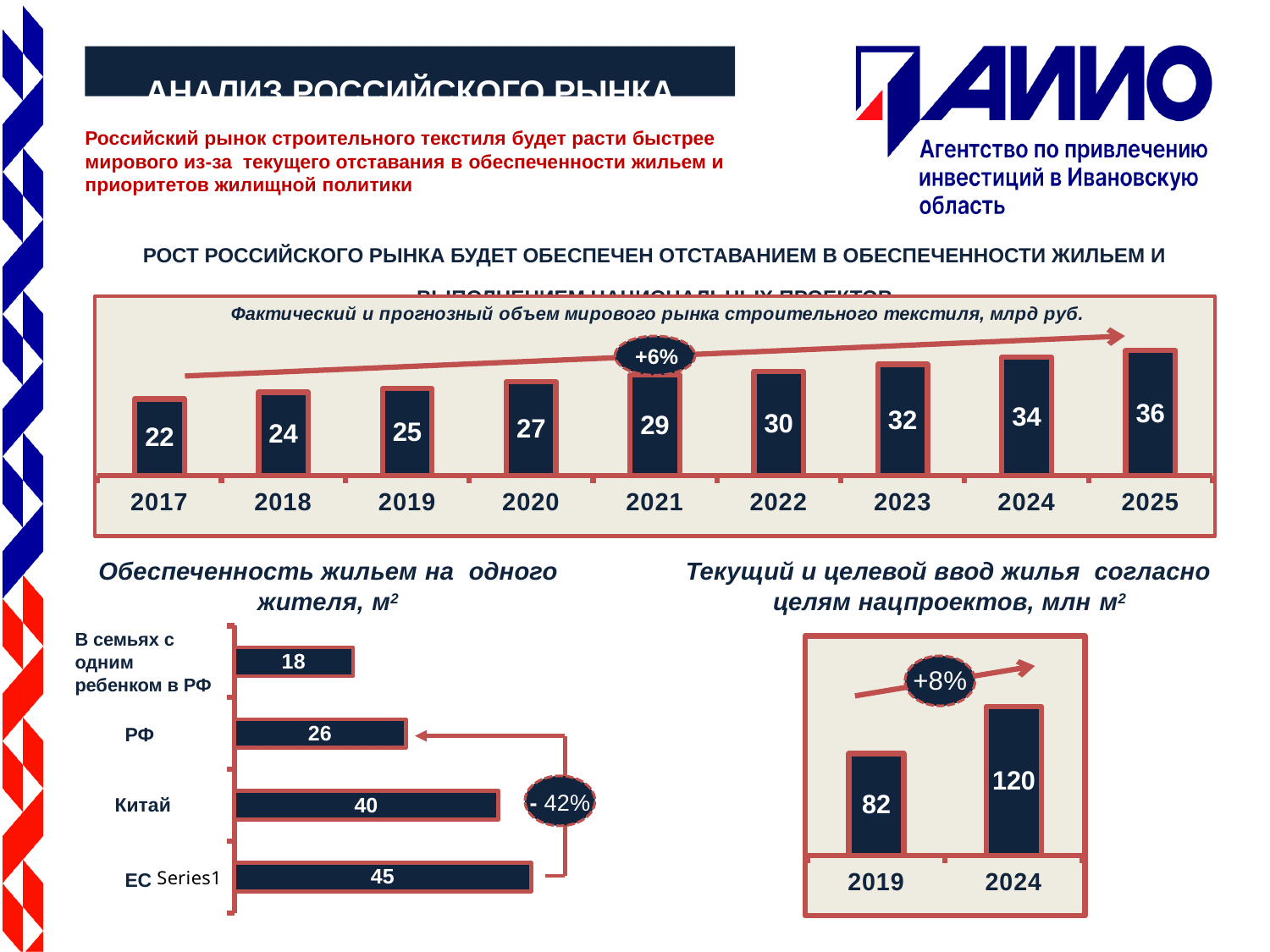
In the top chart (Фактический и прогнозный объем мирового рынка строительного текстиля), what is the difference between the 2025 value and the 2017 value? 14 In the bottom-right chart (Текущий и целевой ввод жилья согласно целям нацпроектов, млн м²), what is the value for 2024? 120 In the top chart (Фактический и прогнозный объем мирового рынка строительного текстиля), which year has the highest value? 2025 What kind of chart is the bottom-left chart (Обеспеченность жильем на одного жителя, м²)? bar chart In the bottom-left chart (Обеспеченность жильем на одного жителя, м²), what is the difference between ЕС and РФ? 19 In the bottom-left chart (Обеспеченность жильем на одного жителя, м²), which category has the lowest value? В семьях с одним ребенком в РФ In the top chart (Фактический и прогнозный объем мирового рынка строительного текстиля), what is the value for 2021? 29 In the bottom-left chart (Обеспеченность жильем на одного жителя, м²), what is the value for Китай? 40 In the top chart (Фактический и прогнозный объем мирового рынка строительного текстиля), do the values rise or fall from 2017 to 2025? rise In the bottom-right chart (Текущий и целевой ввод жилья согласно целям нацпроектов, млн м²), what percentage is shown in the oval above the bars? +8% In the top chart (Фактический и прогнозный объем мирового рынка строительного текстиля), how many years are shown on the x axis? 9 In the bottom-right chart (Текущий и целевой ввод жилья согласно целям нацпроектов, млн м²), which is larger, 2019 or 2024? 2024